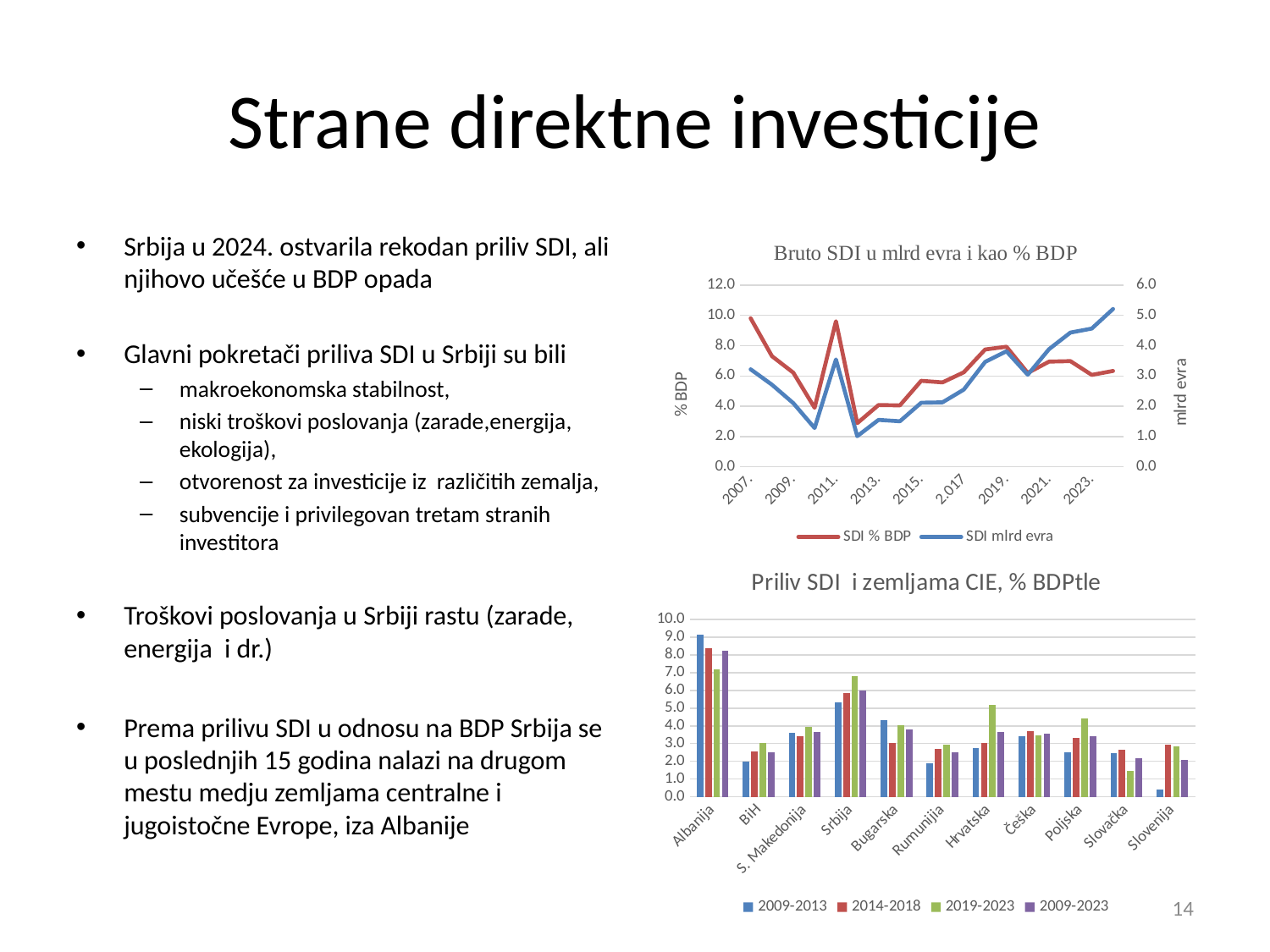
In the top chart 'Bruto SDI u mlrd evra i kao % BDP', does the SDI mlrd evra series overall rise or fall from 2007 to 2023? rise In the top chart 'Bruto SDI u mlrd evra i kao % BDP', is the value of SDI mlrd evra in 2023 greater or less than 4.0 on the right axis? greater How many series does the legend of the top chart 'Bruto SDI u mlrd evra i kao % BDP' list? 2 In the bottom chart 'Priliv SDI i zemljama CIE, % BDPtle', is the 2019-2023 value for Hrvatska greater or less than 4.0? greater In the top chart 'Bruto SDI u mlrd evra i kao % BDP', is the value of SDI % BDP in 2007 greater or less than 8.0? greater How many countries are shown on the x axis of the bottom chart 'Priliv SDI i zemljama CIE, % BDPtle'? 11 What type of chart is the top chart titled 'Bruto SDI u mlrd evra i kao % BDP'? line chart In the bottom chart 'Priliv SDI i zemljama CIE, % BDPtle', which country has the lowest value for 2009-2013? Slovenija In the bottom chart 'Priliv SDI i zemljama CIE, % BDPtle', which country has the highest value for 2009-2013? Albanija In the bottom chart 'Priliv SDI i zemljama CIE, % BDPtle', which is larger for 2009-2013: Bugarska or Rumunija? Bugarska What type of chart is the bottom chart titled 'Priliv SDI i zemljama CIE, % BDPtle'? bar chart How many series does the legend of the bottom chart 'Priliv SDI i zemljama CIE, % BDPtle' list? 4